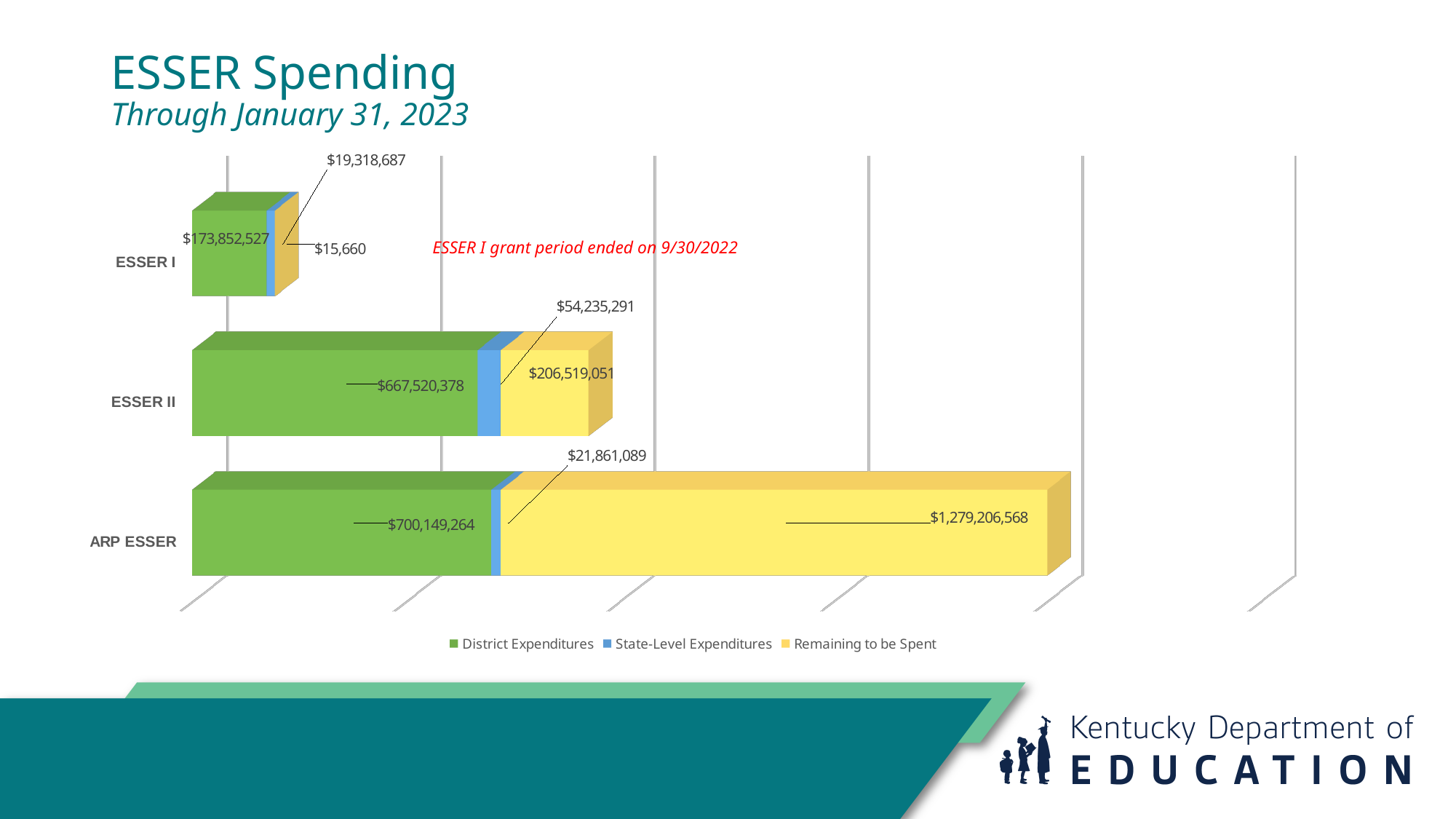
What is the value of Remaining to be Spent for ESSER II? $206,519,051 What is the value of State-Level Expenditures for ESSER I? $19,318,687 What is the difference between District Expenditures for ARP ESSER and for ESSER II? $32,628,886 What is the value of District Expenditures for ARP ESSER? $700,149,264 How many series does the legend list? 3 What kind of chart is shown on the slide? Stacked bar chart What is the value of Remaining to be Spent for ESSER I? $15,660 Which is larger: State-Level Expenditures for ESSER II or for ARP ESSER? ESSER II What is the total of the ESSER I stacked bar? $193,186,874 Which category has the highest Remaining to be Spent value? ARP ESSER How many categories (grant programs) are plotted on the chart? 3 Which category has the lowest District Expenditures value? ESSER I